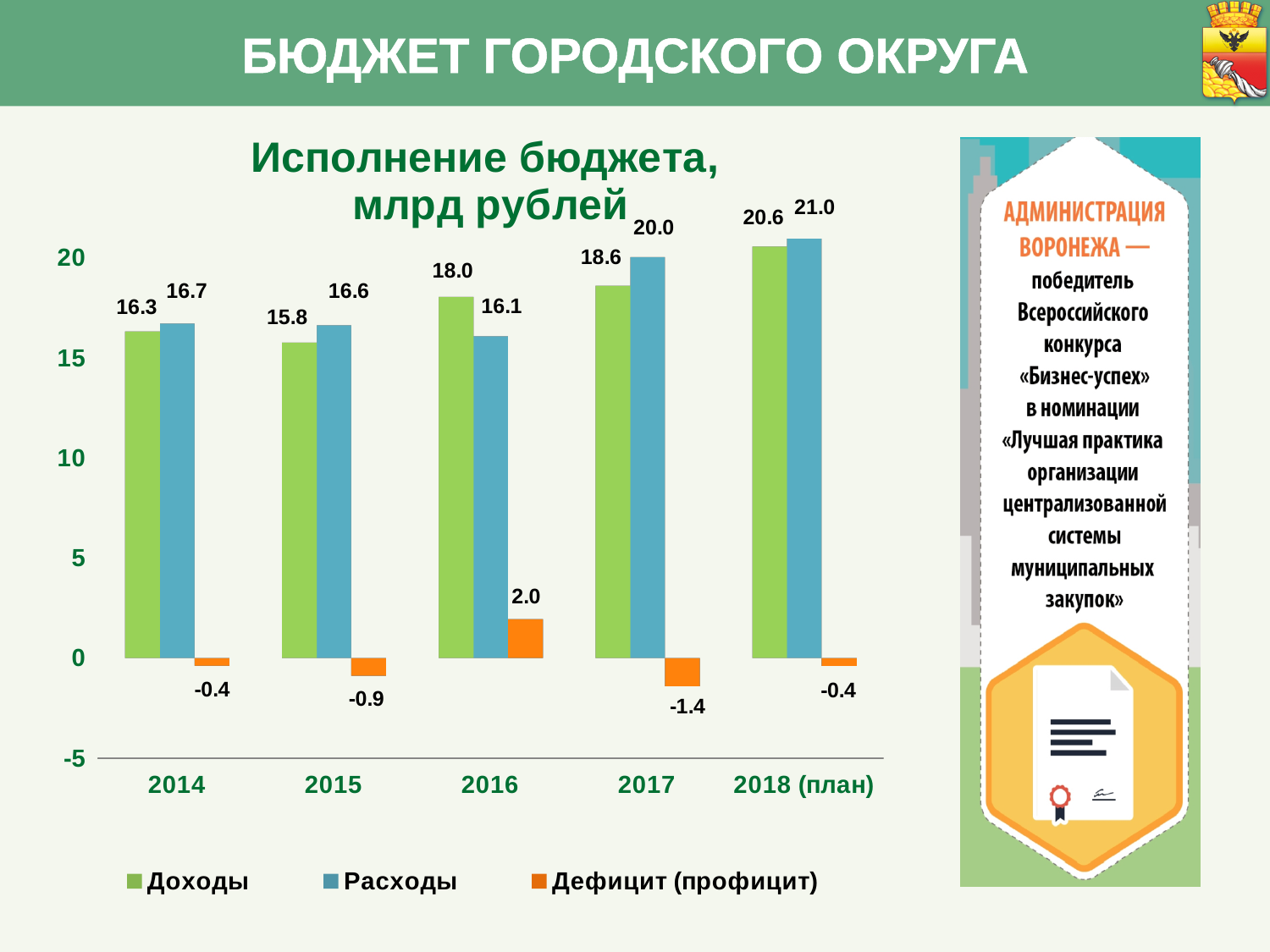
Which is larger in 2016, Доходы or Расходы? Доходы What is the title of the chart? Исполнение бюджета, млрд рублей What kind of chart is shown? bar chart How many series does the legend list? 3 What is the difference between Расходы and Доходы in 2017? 1.4 How many years are shown on the x axis? 5 Which year has the lowest value for Доходы? 2015 Is the value for Доходы in 2018 (план) greater or less than 20? greater Which year has the highest value for Расходы? 2018 (план) What is the value of Доходы for 2016? 18.0 What is the value of Дефицит (профицит) for 2017? -1.4 What is the value of Расходы for 2015? 16.6